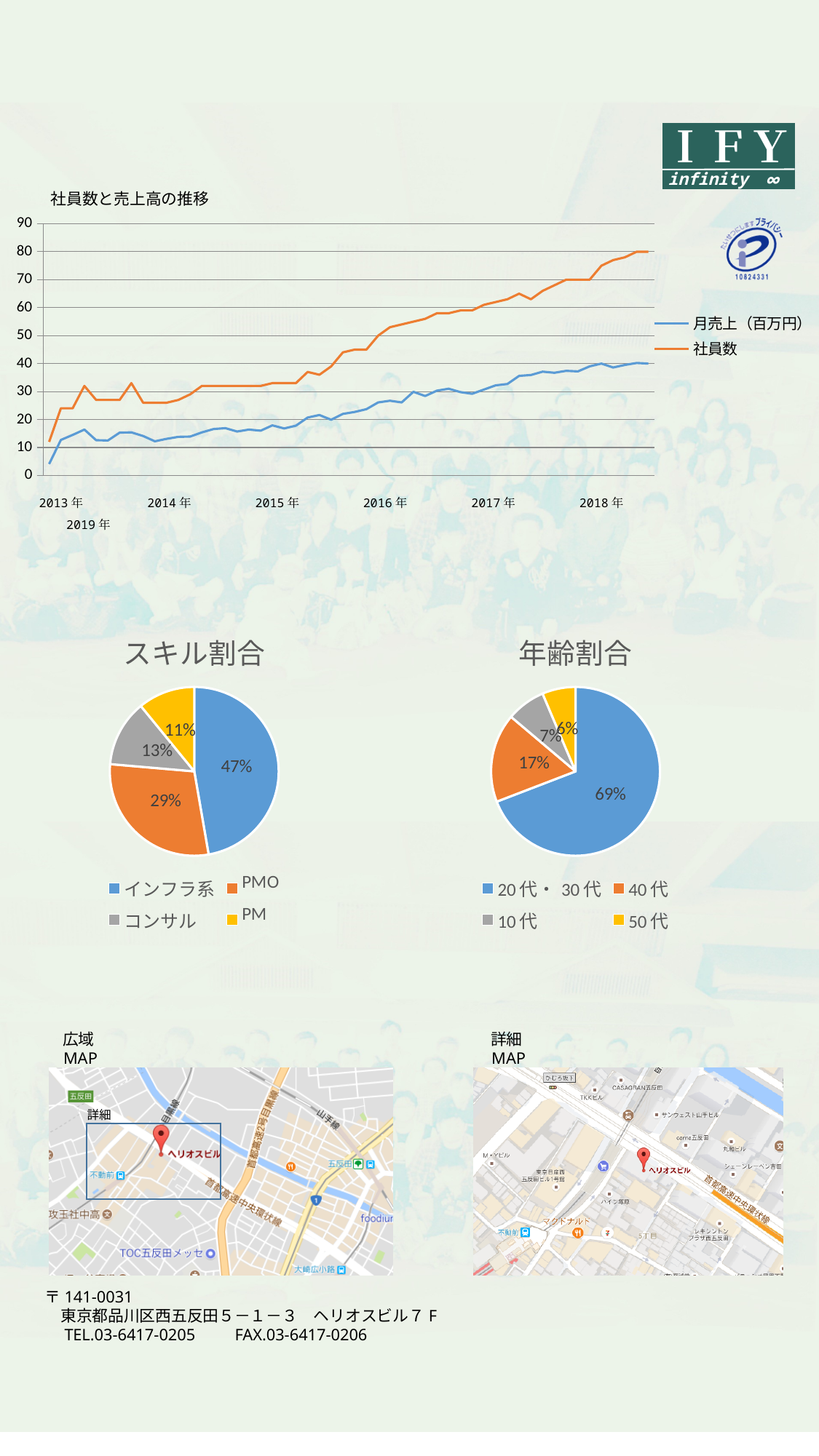
In the 年齢割合 pie chart, which is larger, 40代 or 10代? 40代 In the 社員数と売上高の推移 chart, is the final value of the 社員数 series greater or less than 70? greater How many series does the legend of the 社員数と売上高の推移 chart list? 2 What kind of chart is the chart titled 社員数と売上高の推移? line chart In the 社員数と売上高の推移 chart, does the 社員数 series rise or fall from 2013年 to 2018年? rise In the 社員数と売上高の推移 chart, is the final value of the 月売上（百万円） series greater or less than 50? less How many categories does the 年齢割合 pie chart show? 4 In the スキル割合 pie chart, what share does インフラ系 have? 47% In the スキル割合 pie chart, what is the value for PMO? 29% In the スキル割合 pie chart, what is the difference between the shares of インフラ系 and PMO? 18% In the スキル割合 pie chart, which category has the smallest share? PM In the 年齢割合 pie chart, what share does 20代・30代 have? 69%